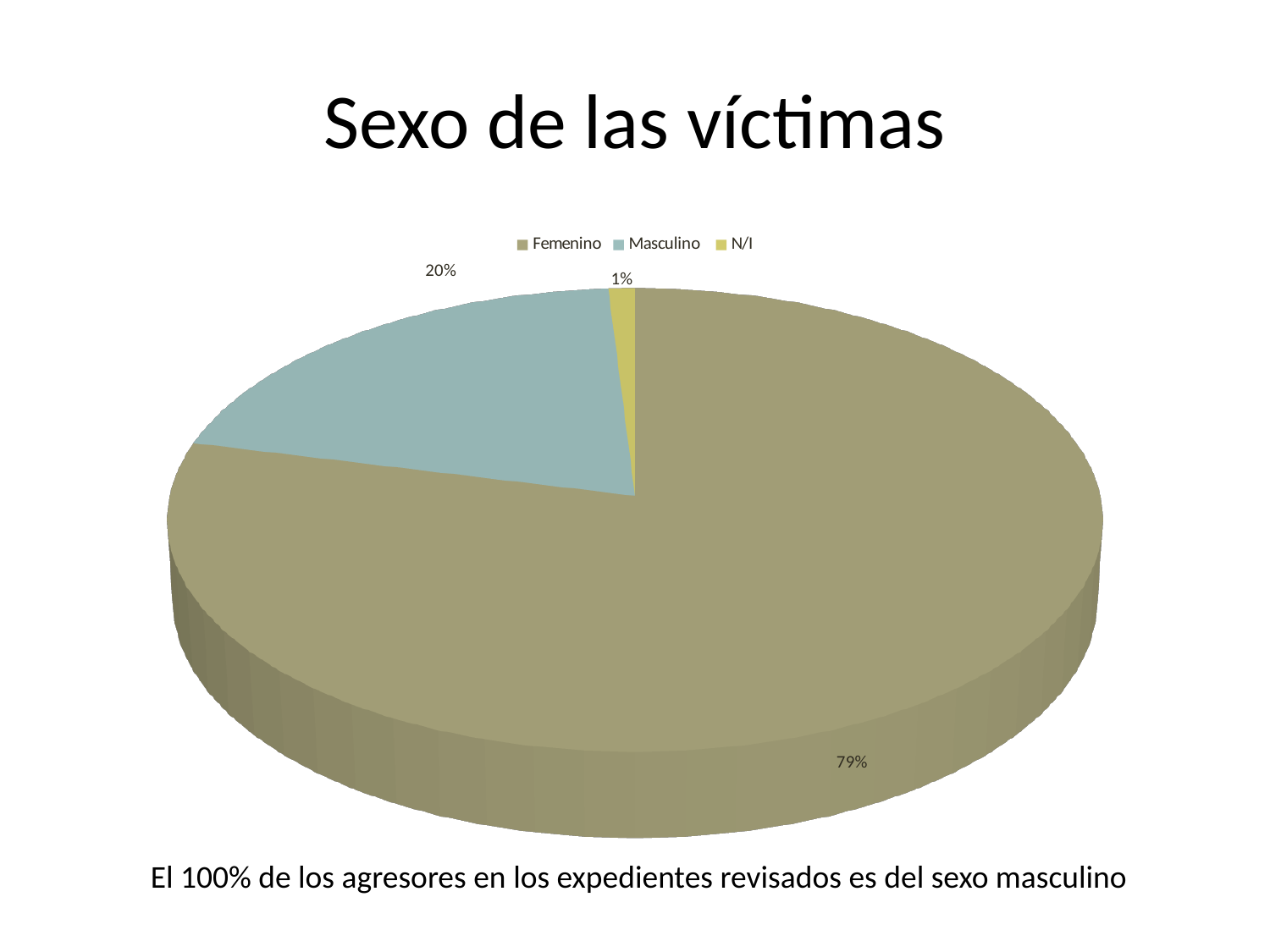
How many categories does the pie chart show? 3 Which slice is larger, Masculino or N/I? Masculino What are the legend entries of the chart? Femenino, Masculino, N/I What is the difference in percentage points between the Femenino and Masculino slices? 59 Which category has the largest slice of the pie? Femenino What kind of chart is shown on the slide? Pie chart What share of the pie does Masculino represent? 20% What is the difference in percentage points between the Masculino and N/I slices? 19 What share of the pie does N/I represent? 1% What is the title of the slide? Sexo de las víctimas Which category has the smallest slice of the pie? N/I What share of the pie does Femenino represent? 79%